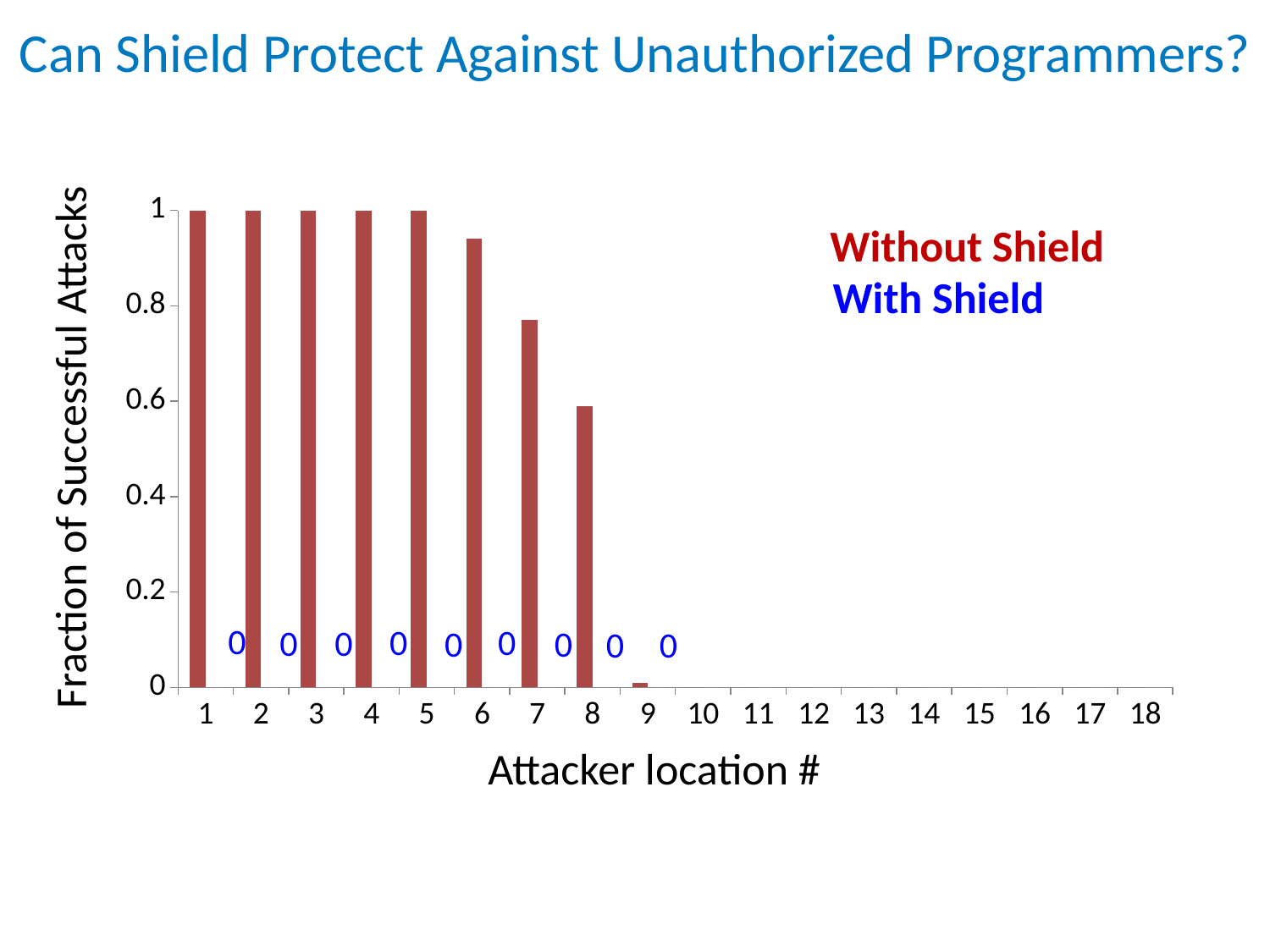
Is the Without Shield value at attacker location 7 greater or less than 0.8? less Among attacker locations 6 to 9, which has the highest Without Shield value? 6 What is the With Shield fraction of successful attacks at attacker location 5? 0 Do the Without Shield values rise or fall from attacker location 5 to attacker location 9? fall What is the Without Shield fraction of successful attacks at attacker location 1? 1 Is the Without Shield value at attacker location 6 greater or less than 0.8? greater How many attacker locations are labelled on the x axis? 18 Is the Without Shield value at attacker location 8 greater or less than 0.4? greater How many series does the legend list? 2 What is the title of the x axis? Attacker location # Which has the larger Without Shield value, attacker location 6 or attacker location 8? attacker location 6 What kind of chart is shown on the slide? bar chart